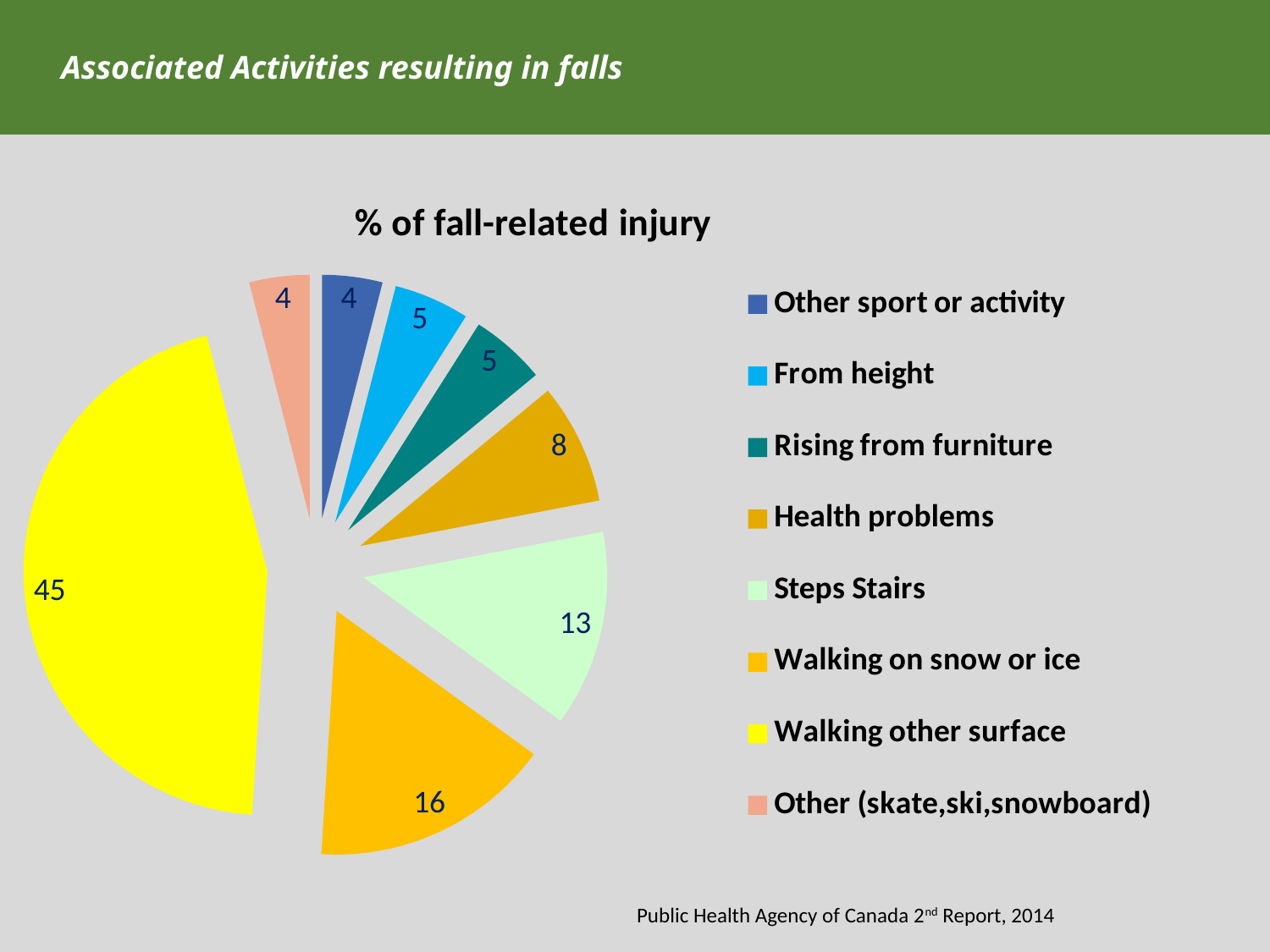
What is the difference between the values for Walking on snow or ice and Steps Stairs? 3 What is the value for Walking other surface? 45 What is the value for Walking on snow or ice? 16 How many categories does the pie chart have? 8 What kind of chart is shown on the slide? pie chart Which legend entry is shown with a yellow colour? Walking other surface Which category has the largest slice? Walking other surface What is the value for Health problems? 8 What is the difference between the values for Walking other surface and Walking on snow or ice? 29 What is the title of the chart? % of fall-related injury Which is larger, the value for Health problems or the value for From height? Health problems What is the value for Steps Stairs? 13